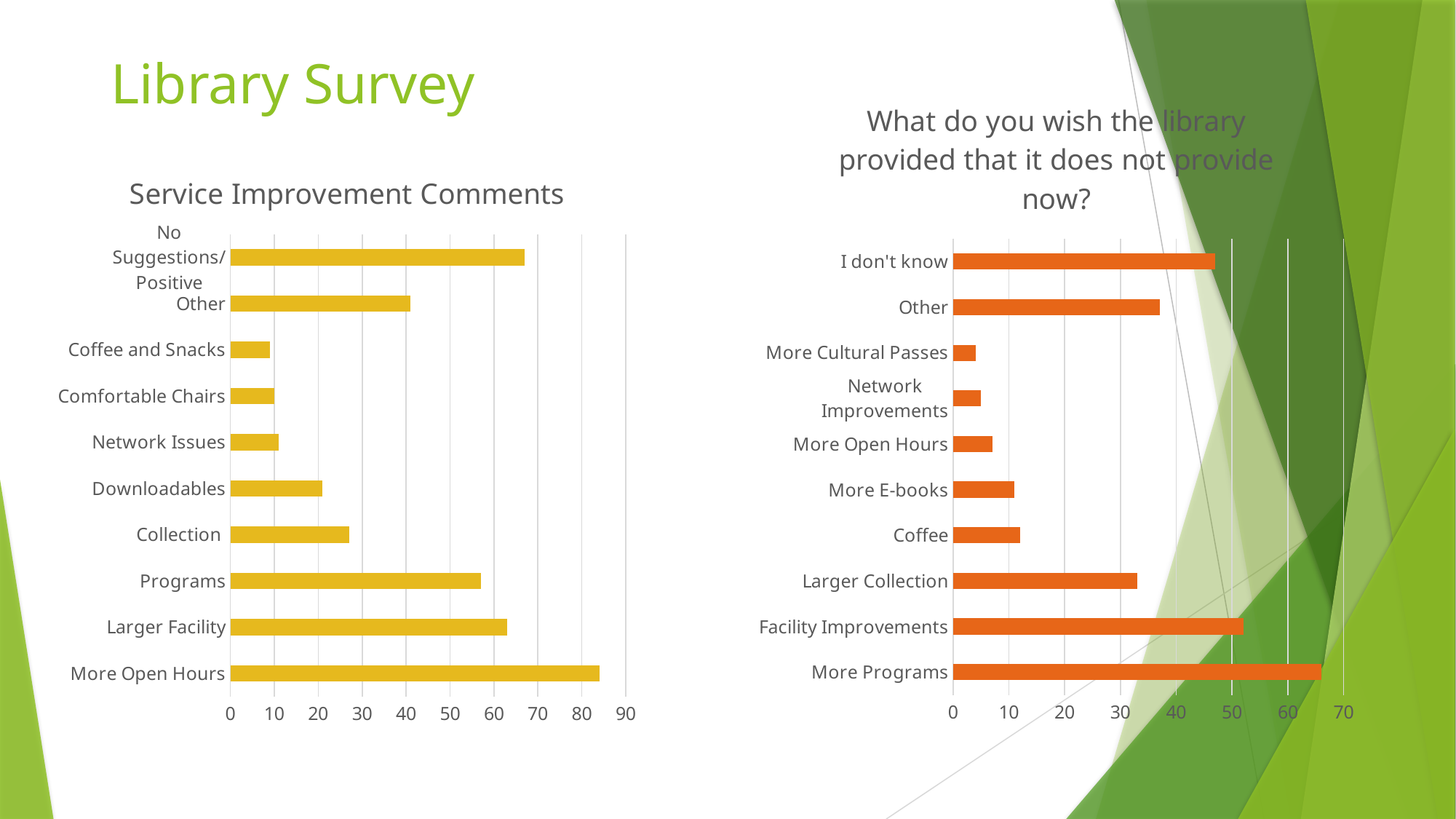
On the Service Improvement Comments chart, is the value for Programs greater or less than 50? greater On the Service Improvement Comments chart, which category has the highest value? More Open Hours On the chart titled 'What do you wish the library provided that it does not provide now?', which is larger, I don't know or Other? I don't know On the chart titled 'What do you wish the library provided that it does not provide now?', is the value for I don't know greater or less than 50? less On the Service Improvement Comments chart, is the value for More Open Hours greater or less than 80? greater How many categories are shown on the chart titled 'What do you wish the library provided that it does not provide now?' 10 What kind of chart is the Service Improvement Comments chart? bar chart On the chart titled 'What do you wish the library provided that it does not provide now?', which category has the highest value? More Programs On the Service Improvement Comments chart, which is larger, Larger Facility or Programs? Larger Facility How many categories are shown on the Service Improvement Comments chart? 10